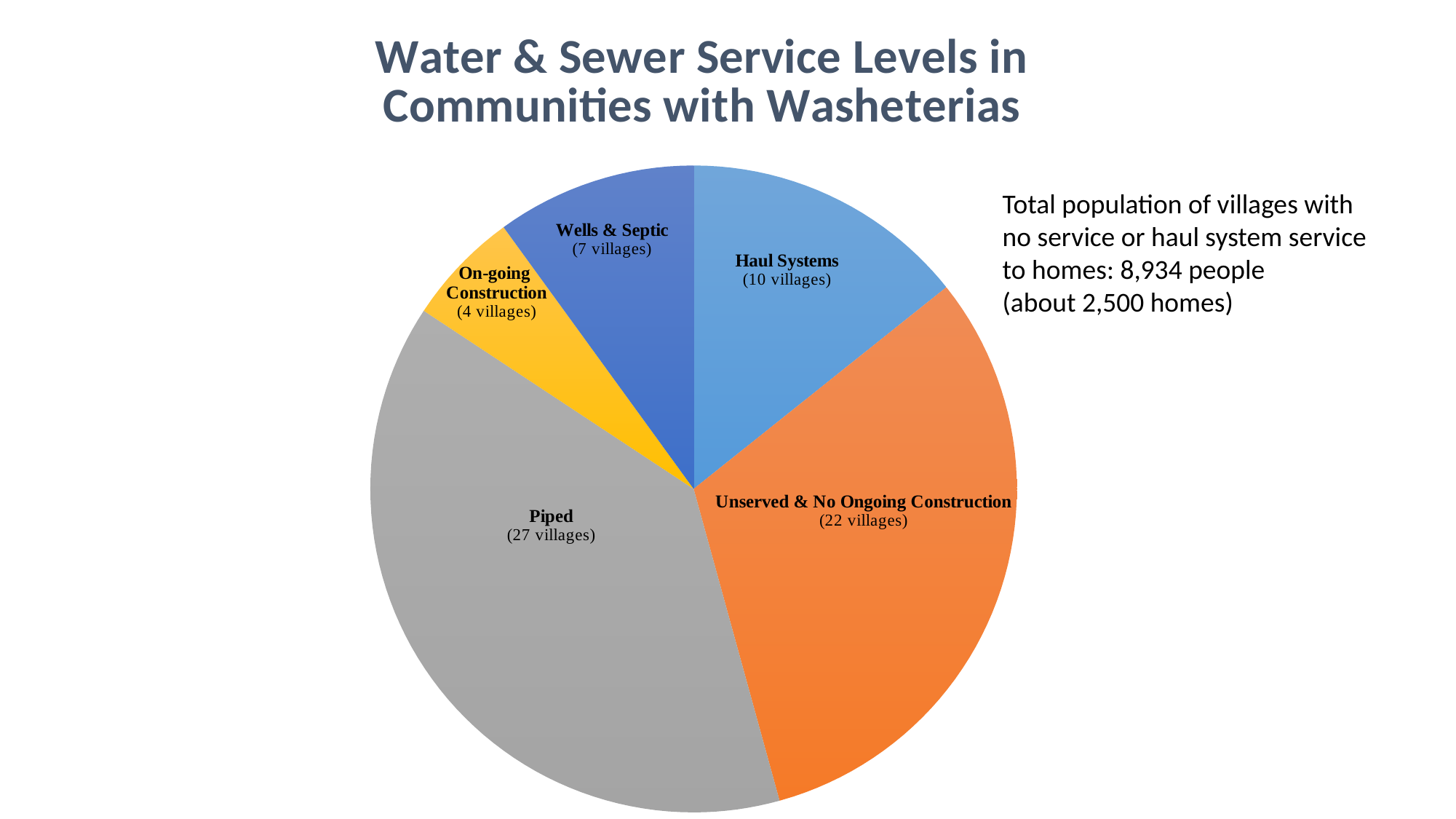
Which category has the most villages? Piped What type of chart is shown on the slide? Pie chart What is the difference in villages between Haul Systems and Wells & Septic? 3 How many more villages are Piped than Unserved & No Ongoing Construction? 5 How many villages are in the Unserved & No Ongoing Construction slice? 22 villages What is the total number of villages across all slices of the pie chart? 70 How many villages are in the Piped slice? 27 villages How many villages are in the On-going Construction slice? 4 villages How many villages are in the Haul Systems slice? 10 villages How many categories does the pie chart show? 5 Which category has the fewest villages? On-going Construction Which has more villages, Wells & Septic or Haul Systems? Haul Systems